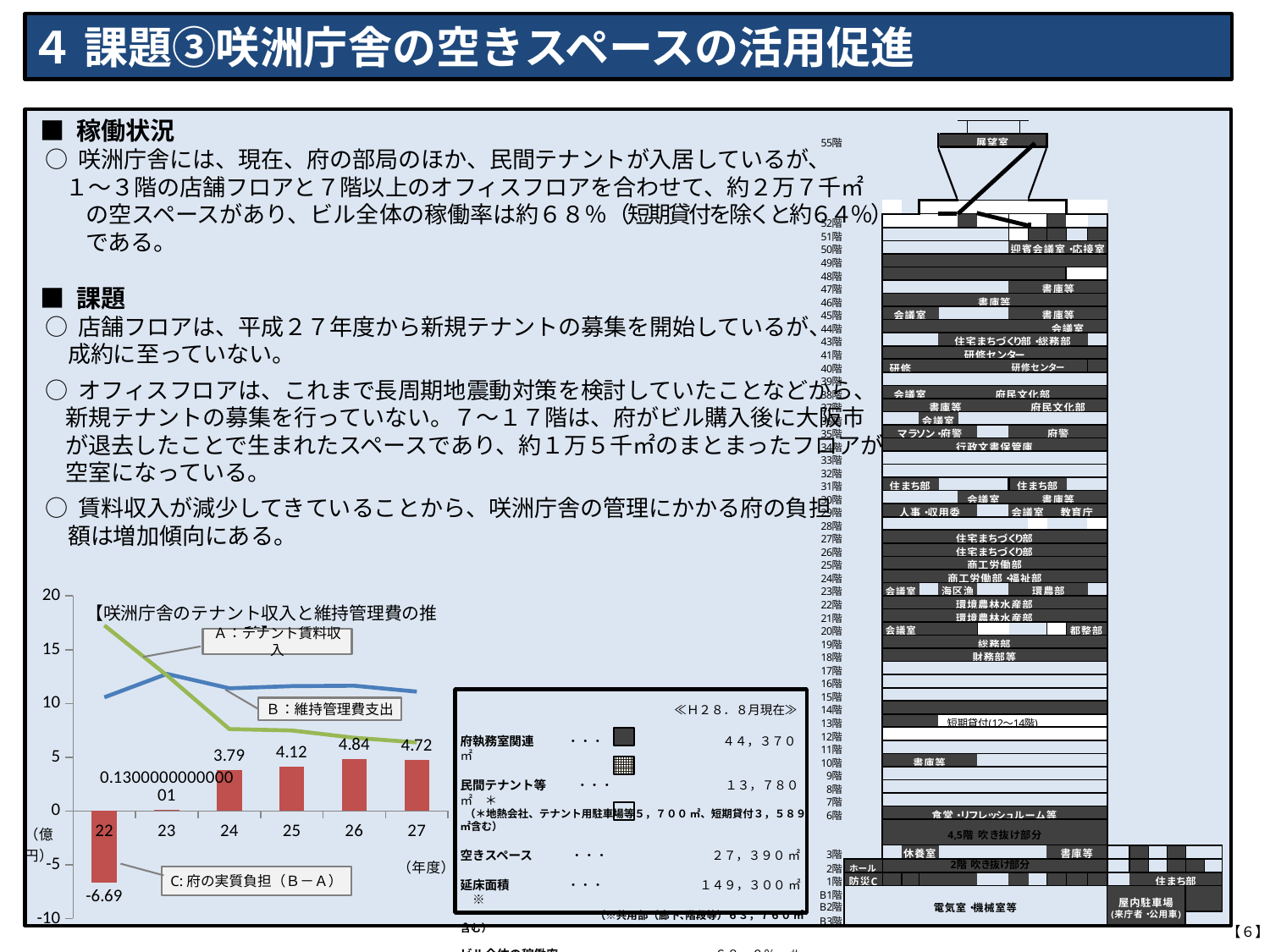
In the bottom-left chart, what is the value of C: 府の実質負担（B−A） for year 24? 3.79 In the bottom-left chart, which is larger, the C: 府の実質負担 value for year 24 or for year 25? 25 In the bottom-left chart, how many years are shown on the x axis? 6 In the bottom-left chart, which year has the highest bar for C: 府の実質負担（B−A）? 26 In the bottom-left chart, is the value of A: テナント賃料収入 for year 22 greater or less than 15? greater In the bottom-left chart, is the value of B: 維持管理費支出 for year 23 greater or less than 10? greater In the bottom-left chart, what is the value of C: 府の実質負担（B−A） for year 26? 4.84 What kind of chart is the bottom-left chart? Combined bar and line chart In the bottom-left chart, does the line A: テナント賃料収入 rise or fall from year 22 to year 27? Fall In the bottom-left chart, what is the difference between the C: 府の実質負担 values for year 26 and year 27? 0.12 In the bottom-left chart, which year has the lowest bar for C: 府の実質負担（B−A）? 22 In the bottom-left chart, what is the value of C: 府の実質負担（B−A） for year 22? -6.69